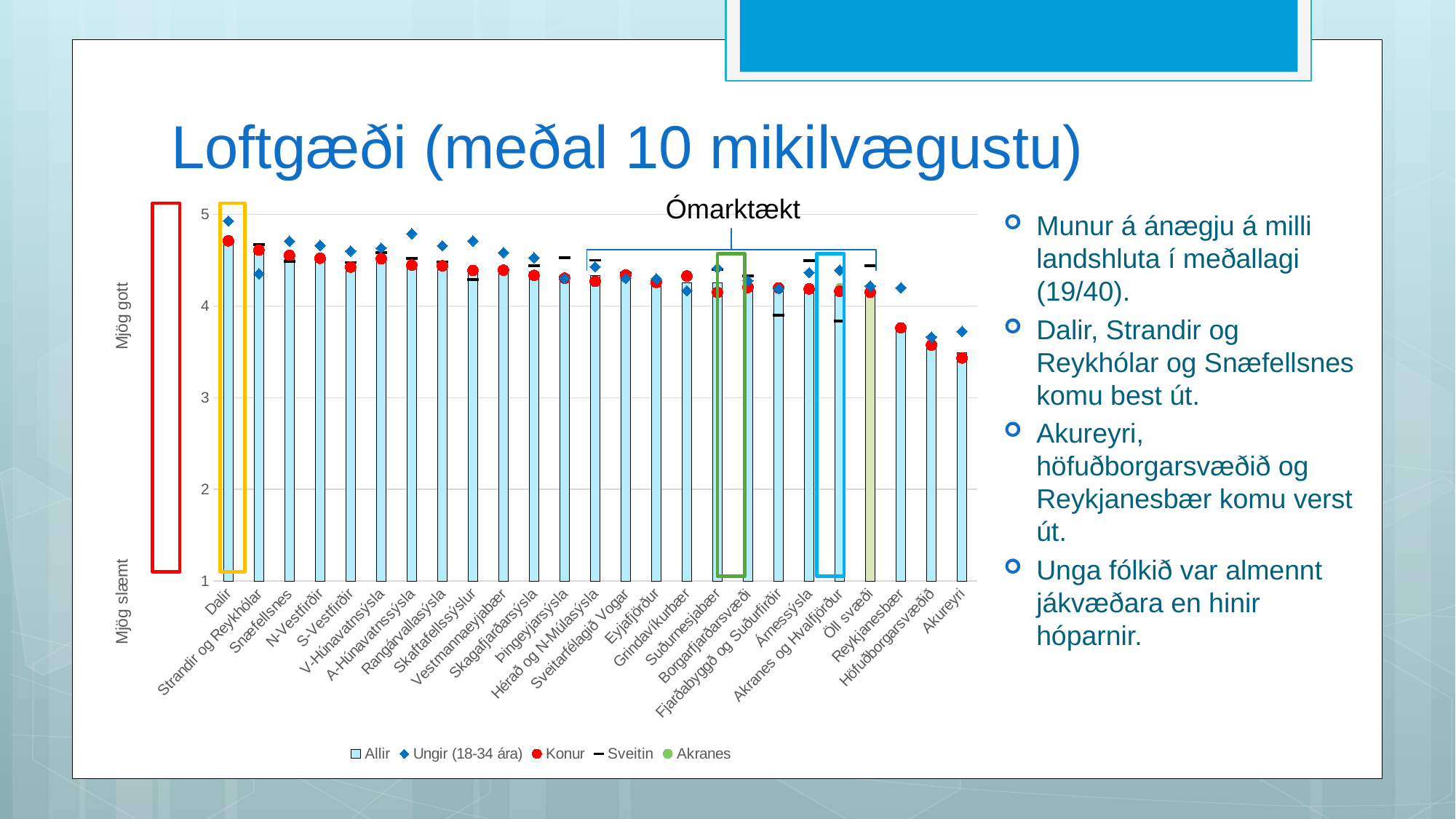
How many categories (regions) are shown along the x axis of the chart? 25 Do the 'Allir' bar values generally rise or fall from left to right along the x axis? Fall Which series in the legend is shown with red circle markers? Konur What is the title of the chart slide? Loftgæði (meðal 10 mikilvægustu) Which has the larger 'Allir' bar, Dalir or Reykjanesbær? Dalir How many series does the chart legend list? 5 Is the 'Ungir (18-34 ára)' value for Dalir greater or less than 4? greater Which category has the highest 'Allir' bar in the chart? Dalir What kind of chart is shown on the slide? Bar chart Is the 'Allir' value for Dalir greater or less than 4? greater Is the 'Allir' value for Akureyri greater or less than 4? less